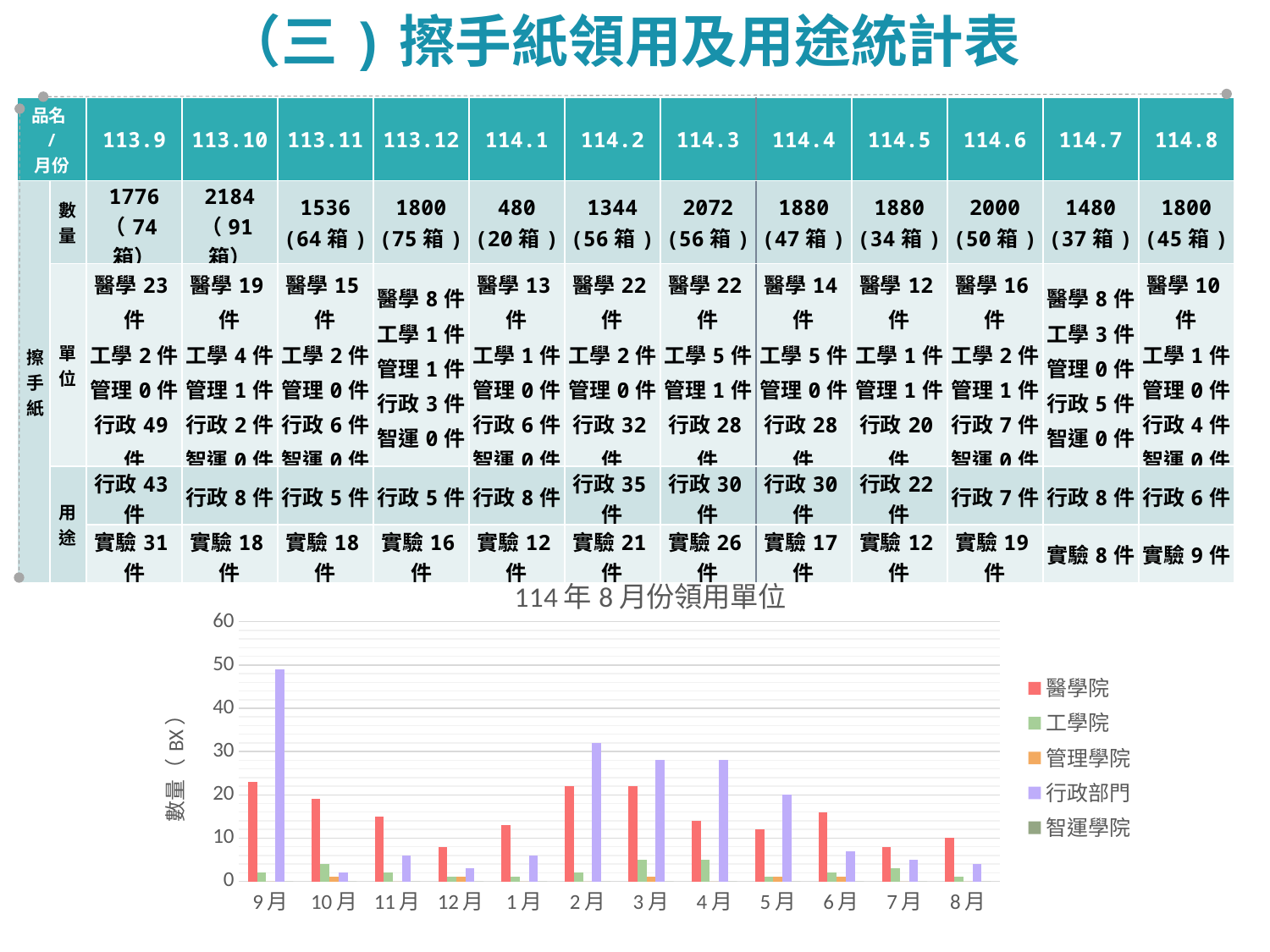
Which is larger: the 行政部門 bar in 9月 or the 行政部門 bar in 2月? 9月 Is the value for 行政部門 in 9月 greater or less than 40? greater What kind of chart is shown on the slide? bar chart What is the label on the vertical axis of the chart? 數量（BX） In 2月, which is larger: the 醫學院 bar or the 行政部門 bar? 行政部門 Is the value for 行政部門 in 3月 greater or less than 20? greater How many series does the chart legend list? 5 In 5月, which is larger: the 醫學院 bar or the 行政部門 bar? 行政部門 How many months are shown along the x axis of the chart? 12 In which month is the 行政部門 bar the highest? 9月 Is the value for 醫學院 in 8月 greater or less than 20? less What is the title of the chart? 114年8月份領用單位